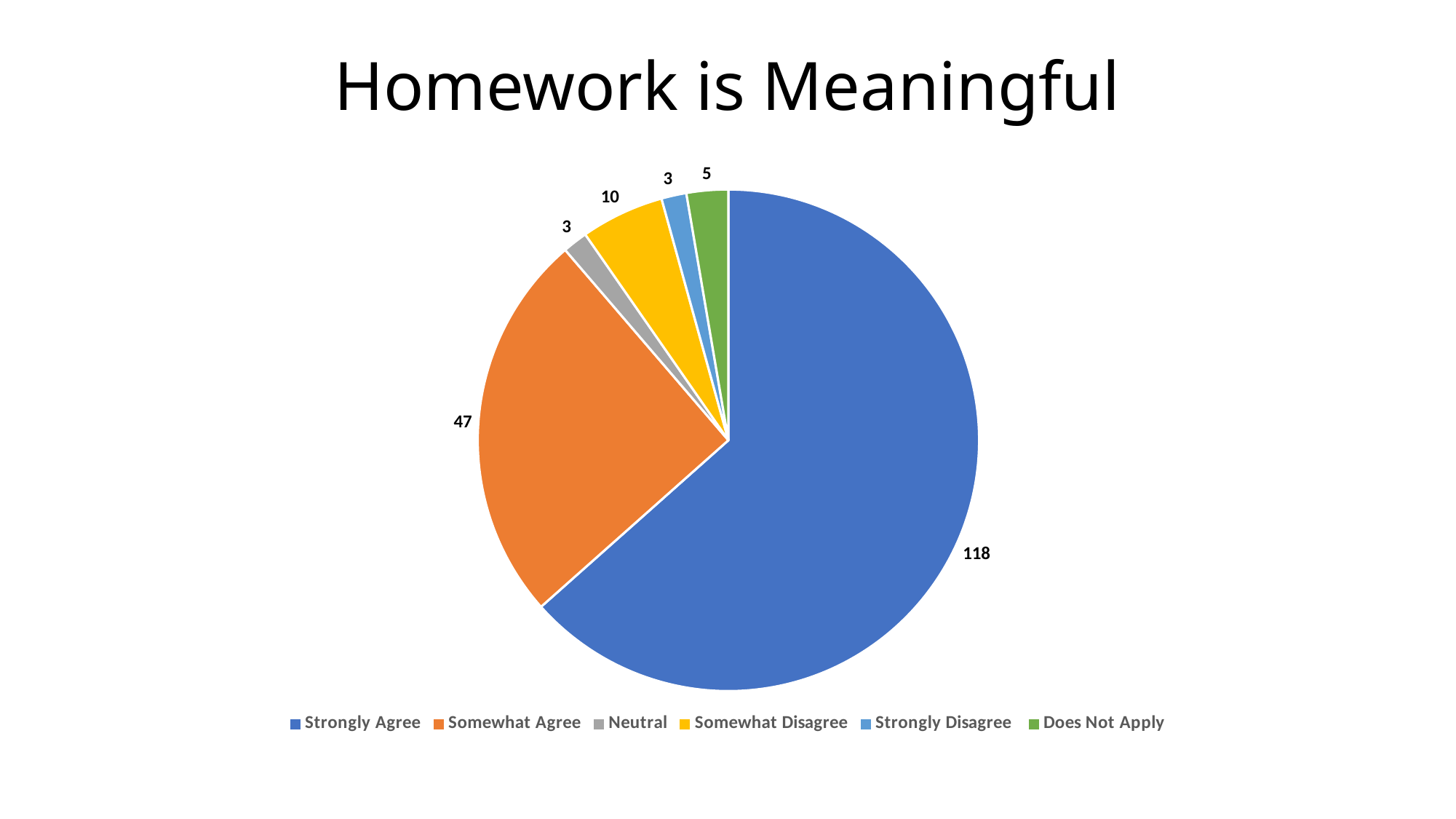
What is the value for Somewhat Disagree? 10 What is the title of the chart? Homework is Meaningful What kind of chart is shown on the slide? Pie chart What colour is the Somewhat Agree slice? Orange What is the value for Somewhat Agree? 47 What is the value for Neutral? 3 What is the value for Does Not Apply? 5 How many categories does the legend list? 6 What is the difference between the Strongly Agree and Somewhat Agree values? 71 What is the value for Strongly Agree? 118 Which category has the largest slice? Strongly Agree Which is larger, Somewhat Disagree or Does Not Apply? Somewhat Disagree